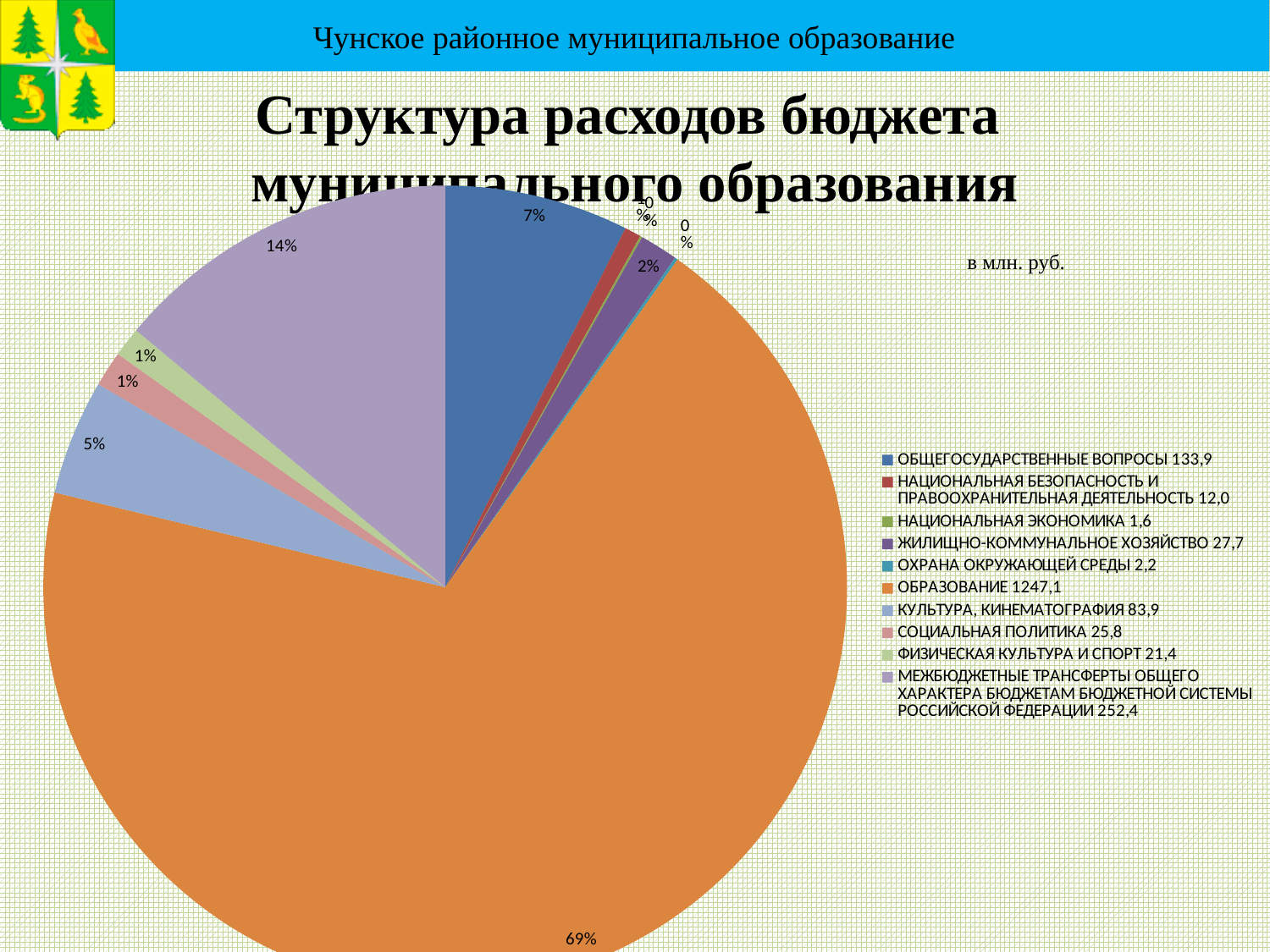
Which category has the largest slice of the pie? ОБРАЗОВАНИЕ Which category has the smallest value in the legend? НАЦИОНАЛЬНАЯ ЭКОНОМИКА What share of the pie does ОБРАЗОВАНИЕ take? 69% What value is given for КУЛЬТУРА, КИНЕМАТОГРАФИЯ in the legend? 83,9 Which is larger, the value for СОЦИАЛЬНАЯ ПОЛИТИКА or the value for ЖИЛИЩНО-КОММУНАЛЬНОЕ ХОЗЯЙСТВО? ЖИЛИЩНО-КОММУНАЛЬНОЕ ХОЗЯЙСТВО What share of the pie does МЕЖБЮДЖЕТНЫЕ ТРАНСФЕРТЫ ОБЩЕГО ХАРАКТЕРА БЮДЖЕТАМ БЮДЖЕТНОЙ СИСТЕМЫ РОССИЙСКОЙ ФЕДЕРАЦИИ take? 14% How many categories does the legend of the pie chart list? 10 What value is given for ОБЩЕГОСУДАРСТВЕННЫЕ ВОПРОСЫ in the legend? 133,9 In what units are the values on the chart given, according to the note on the slide? в млн. руб. What value is given for ОБРАЗОВАНИЕ in the legend? 1247,1 What is the difference between the values for МЕЖБЮДЖЕТНЫЕ ТРАНСФЕРТЫ (252,4) and ОБЩЕГОСУДАРСТВЕННЫЕ ВОПРОСЫ (133,9)? 118,5 What kind of chart is shown on the slide? pie chart